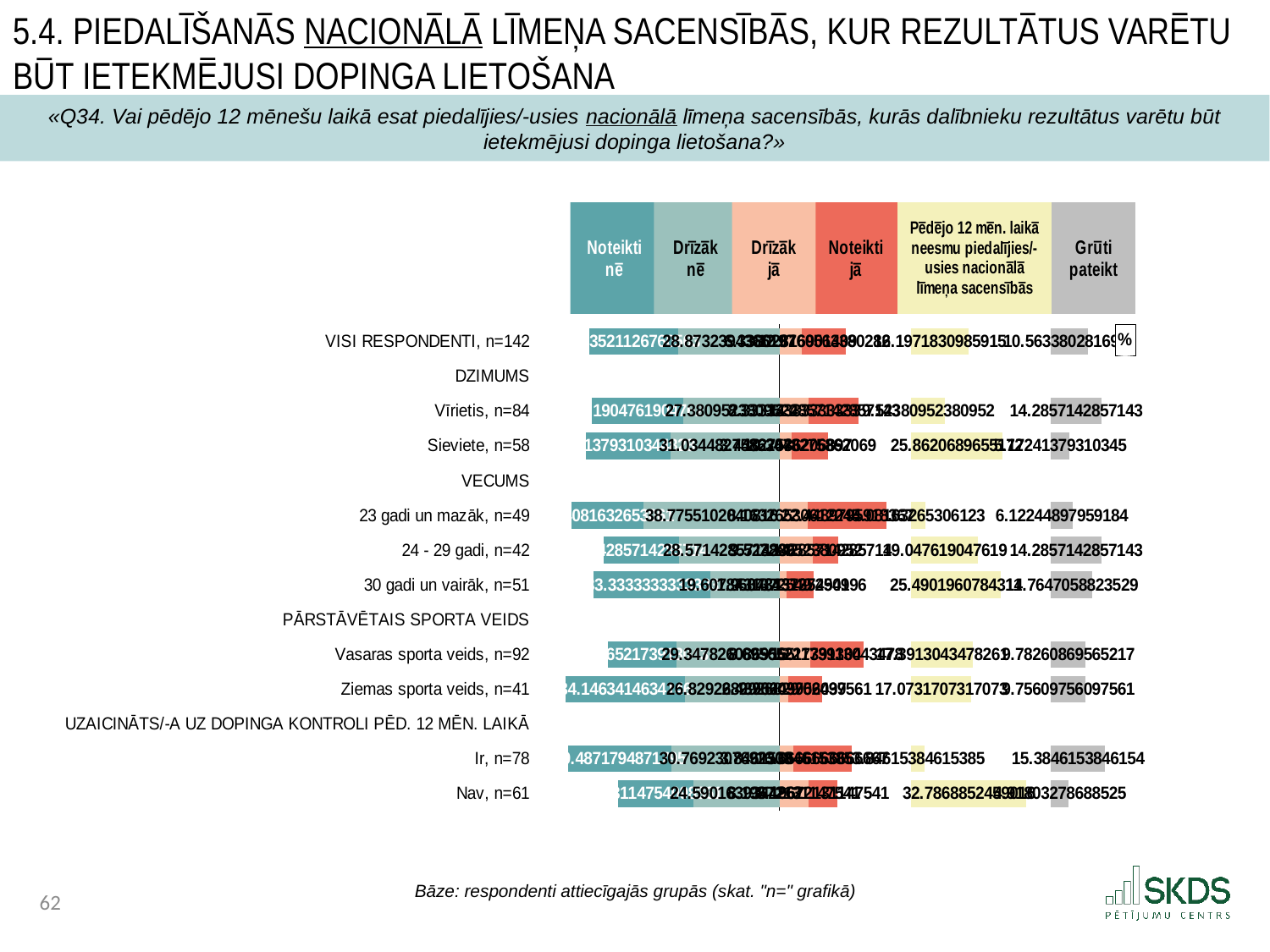
What is the 'Grūti pateikt' value for Ir, n=78? 15.3846153846154 What is the 'Grūti pateikt' value for Vīrietis, n=84? 14.2857142857143 What is the value of 'Pēdējo 12 mēn. laikā neesmu piedalījies/-usies nacionālā līmeņa sacensībās' for Nav, n=61? 32.7868852459016 Which legend entry is shown in grey? Grūti pateikt How many respondent groups (rows with an n value) are plotted in the chart? 10 What is the value of 'Pēdējo 12 mēn. laikā neesmu piedalījies/-usies nacionālā līmeņa sacensībās' for Ziemas sporta veids, n=41? 17.0731707317073 What is the first legend entry (the dark teal series)? Noteikti nē Which group has the larger 'Grūti pateikt' share: Ir, n=78 or Nav, n=61? Ir, n=78 What kind of chart is shown on the slide? stacked bar chart How many series does the legend list? 6 What is the 'Grūti pateikt' value for 23 gadi un mazāk, n=49? 6.12244897959184 Which group has the larger 'Pēdējo 12 mēn. laikā neesmu piedalījies/-usies nacionālā līmeņa sacensībās' share: Ir, n=78 or Nav, n=61? Nav, n=61